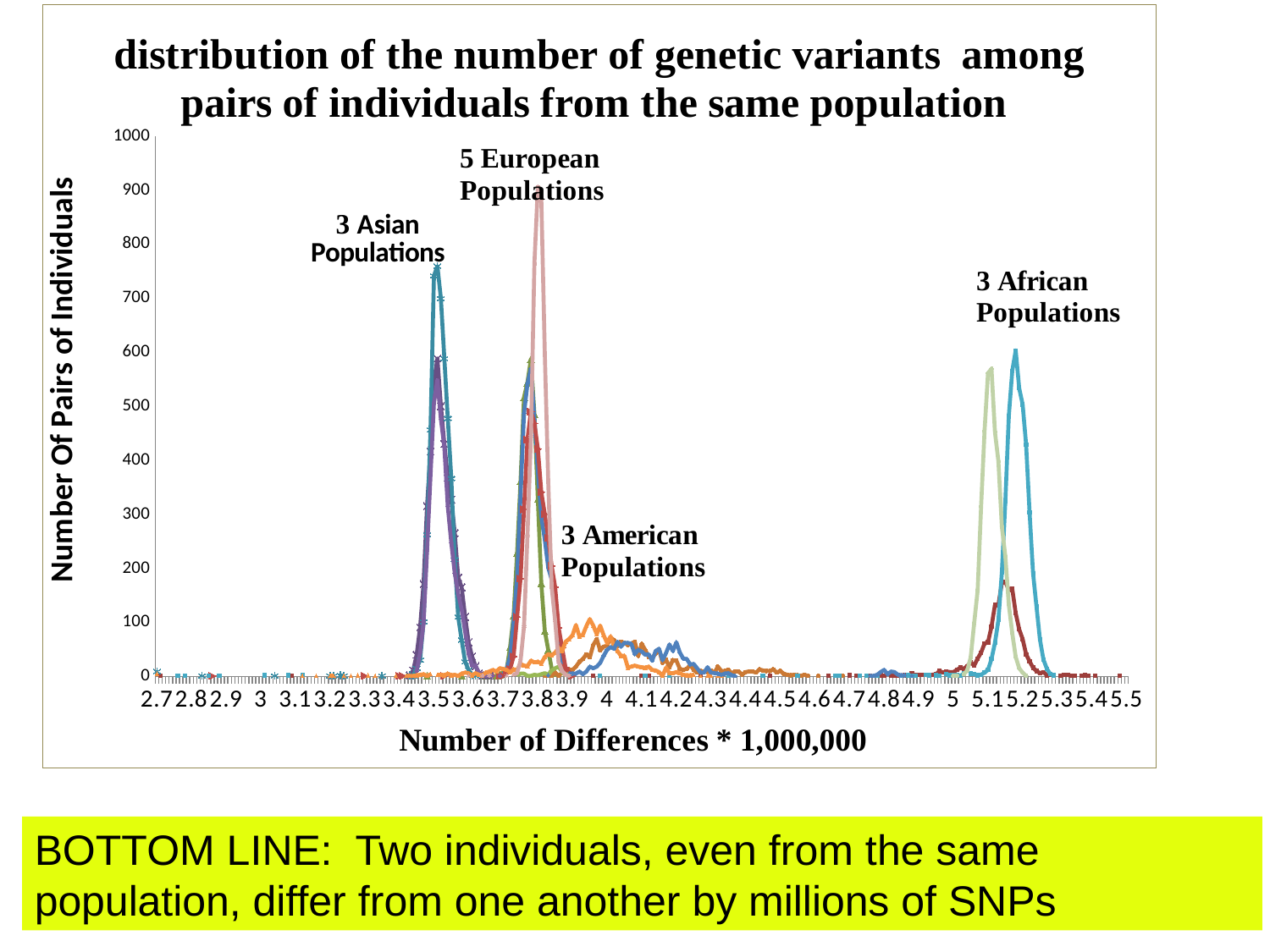
Which labelled population group has the highest peak on the chart? 5 European Populations Is the highest peak of the African populations greater or less than 500? greater How many labelled population groups are annotated on the chart? 4 Is the highest peak of the Asian populations greater or less than 700? greater Which has a higher peak, the Asian populations or the African populations? Asian populations Is the highest peak of the American populations greater or less than 200? less Which labelled population group has its peaks furthest to the right on the x axis (the largest number of differences)? 3 African Populations Which labelled population group has the lowest peak on the chart? 3 American Populations What is the title of the chart? distribution of the number of genetic variants among pairs of individuals from the same population What kind of chart is shown on the slide? line chart What is the label of the y axis? Number Of Pairs of Individuals